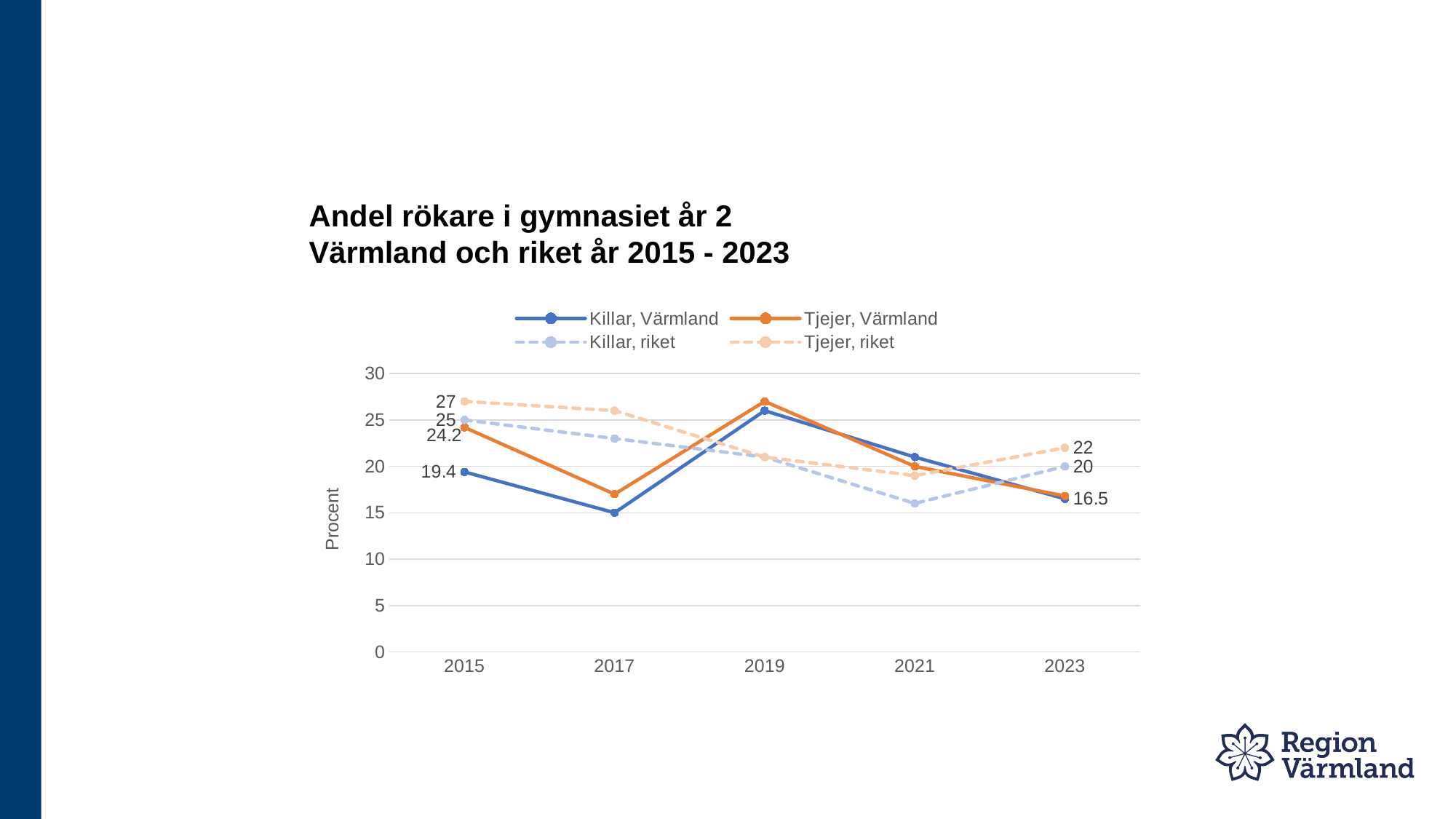
Is the value for Killar, Värmland in 2017 greater or less than 20? less In 2015, which is larger: Tjejer, Värmland or Killar, Värmland? Tjejer, Värmland What is the value for Killar, riket in 2023? 20 How many years are plotted along the x axis? 5 What is the label on the y axis? Procent What is the value for Tjejer, riket in 2015? 27 What is the difference between Tjejer, riket and Killar, riket in 2015? 2 What is the value for Killar, Värmland in 2015? 19.4 What kind of chart is shown on the slide? line chart In which year does Tjejer, Värmland reach its highest value? 2019 How many series does the legend list? 4 What is the value for Tjejer, riket in 2023? 22